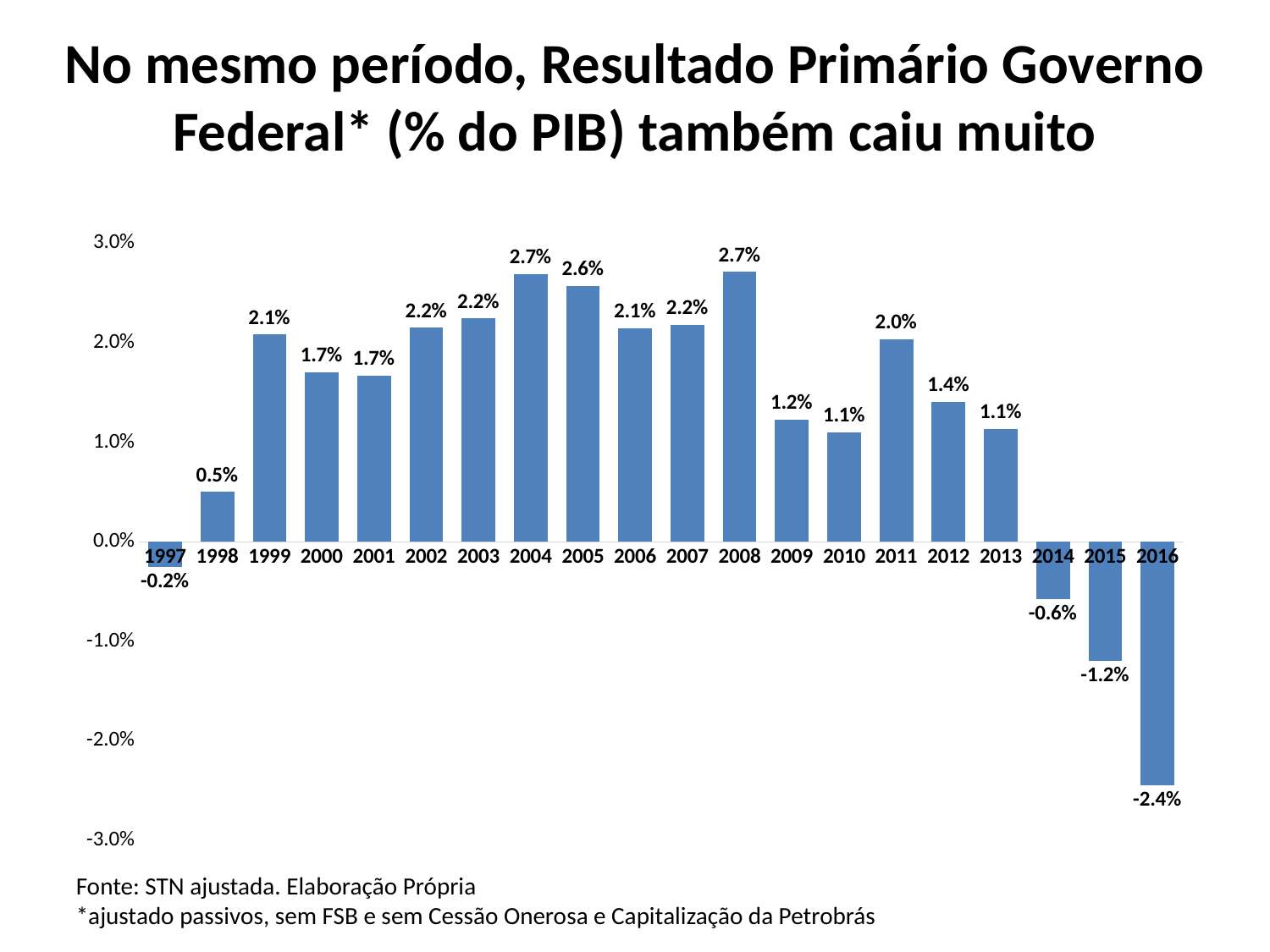
Which is larger, the value for 2011 or the value for 2012? 2011 Do the values rise or fall from 2013 to 2016? Fall What is the difference between the values for 2008 and 2009? 1.5 percentage points What is the value for 2004? 2.7% What is the value for 1998? 0.5% Is the value for 2005 greater or less than 2.0%? greater What is the value for 2016? -2.4% Which year has the lowest value? 2016 What is the value for 2011? 2.0% What kind of chart is shown on the slide? Bar chart What is the source cited below the chart? STN ajustada. Elaboração Própria How many years are shown on the x axis? 20